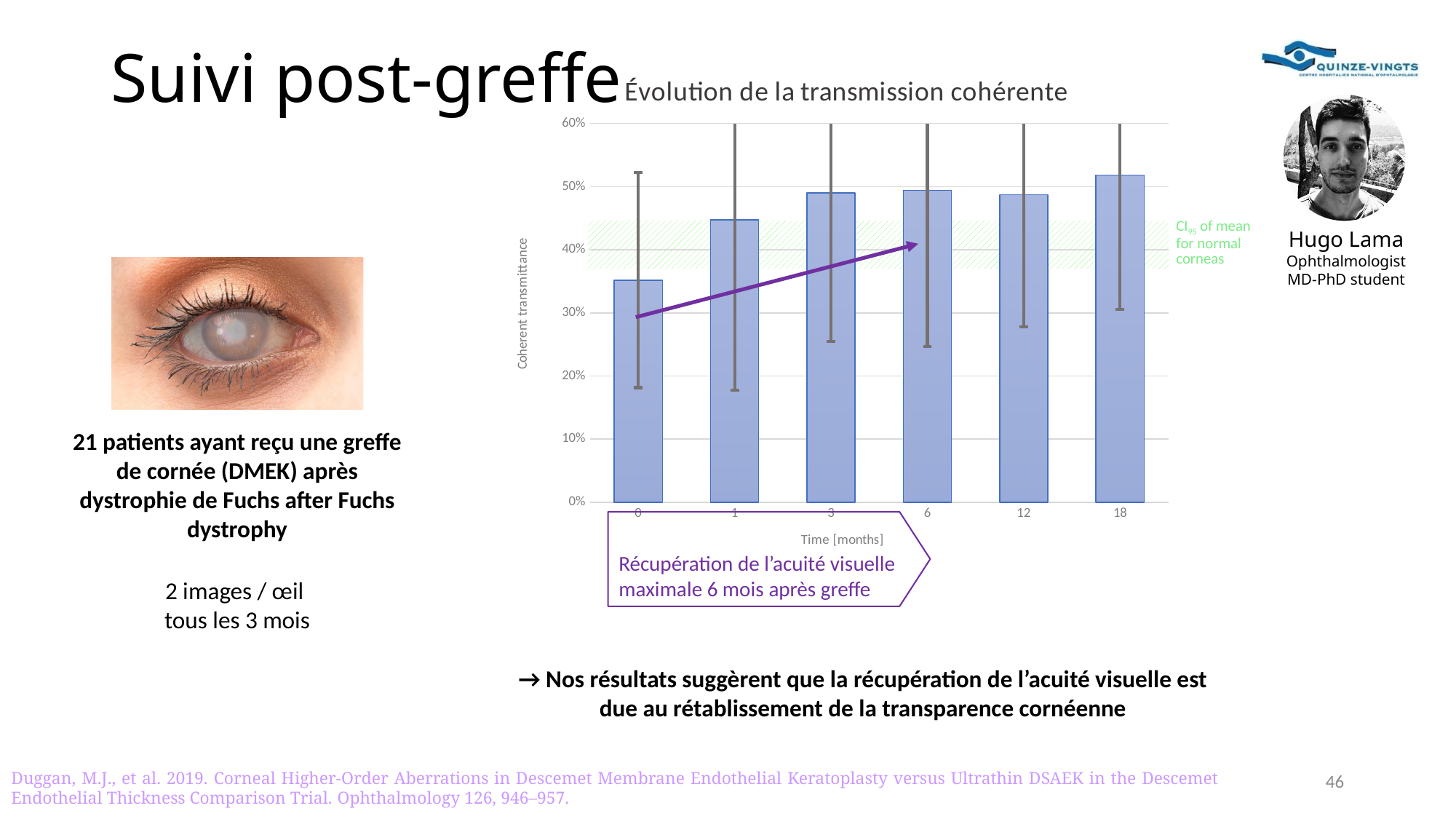
Is the coherent transmittance at 0 months greater or less than 40%? less Does the coherent transmittance generally rise or fall from 0 to 18 months? rise Which time point has the lowest coherent transmittance? 0 Which time point has the highest coherent transmittance? 18 What is the label of the x axis of the chart? Time [months] Which has a higher coherent transmittance, 0 months or 1 month? 1 month Is the coherent transmittance at 18 months greater or less than 50%? greater Is the coherent transmittance at 1 month greater or less than 40%? greater What kind of chart is shown on the slide? bar chart What is the title of the chart? Évolution de la transmission cohérente How many time points (bars) are plotted in the chart? 6